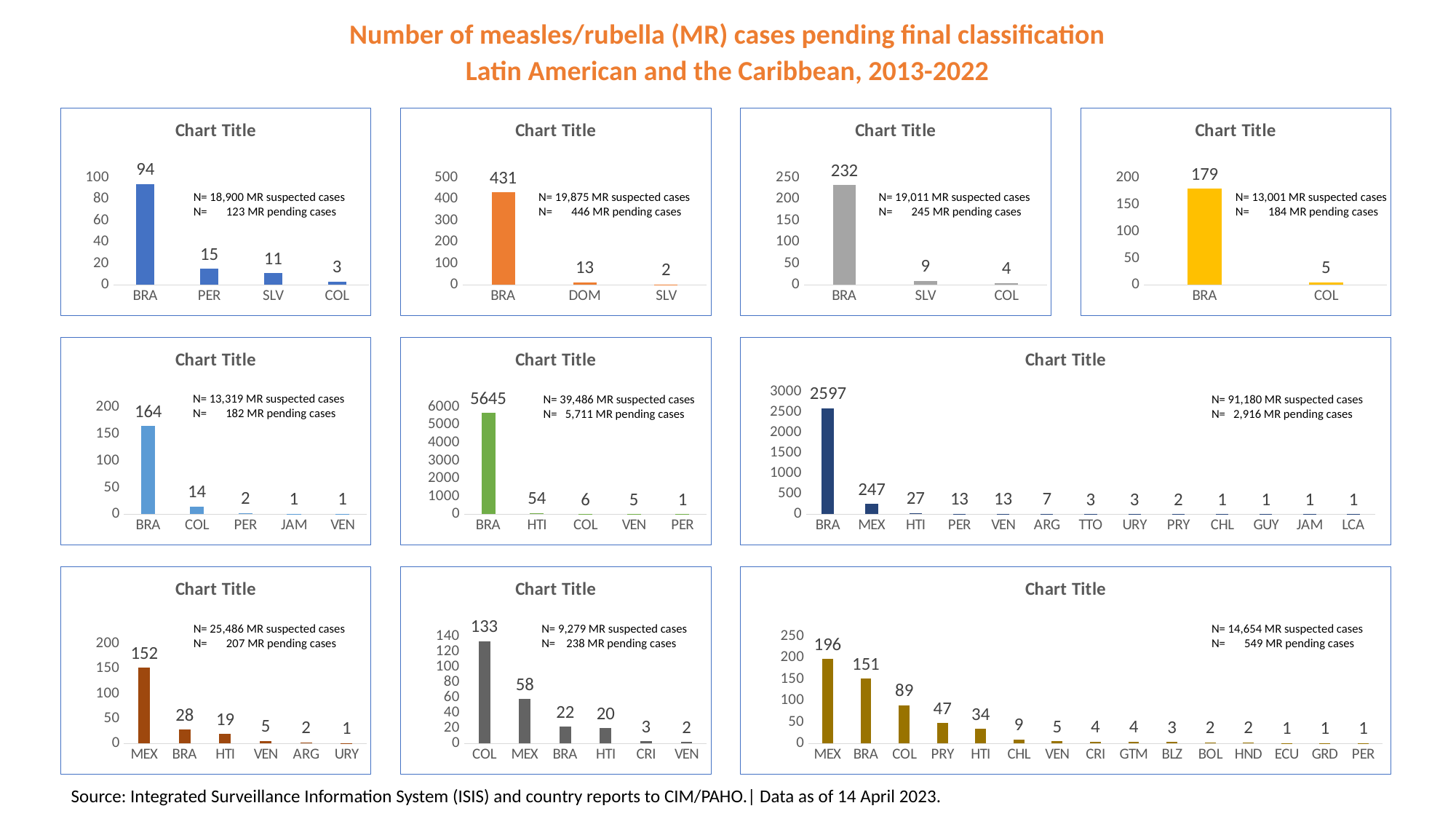
In the second chart of the bottom row (dark gray bars), which category has the lowest value? VEN In the bottom-left chart (brown bars), which is larger, the value for BRA or the value for HTI? BRA In the top-right chart (yellow bars), what is the difference between the values for BRA and COL? 174 In the second chart of the middle row (green bars), what is the value for HTI? 54 In the wide chart on the right of the bottom row, what is the difference between the values for MEX and BRA? 45 How many categories are shown on the x axis of the wide chart on the right of the bottom row? 15 How many categories are shown on the x axis of the wide chart on the right of the middle row? 13 In the middle-left chart (light blue bars), which category has the highest value? BRA In the wide chart on the right of the middle row, what is the value for MEX? 247 In the second chart of the top row (orange bars), what is the value for DOM? 13 What type of chart is the top-left chart? Bar chart In the top-left chart, what is the value for BRA? 94